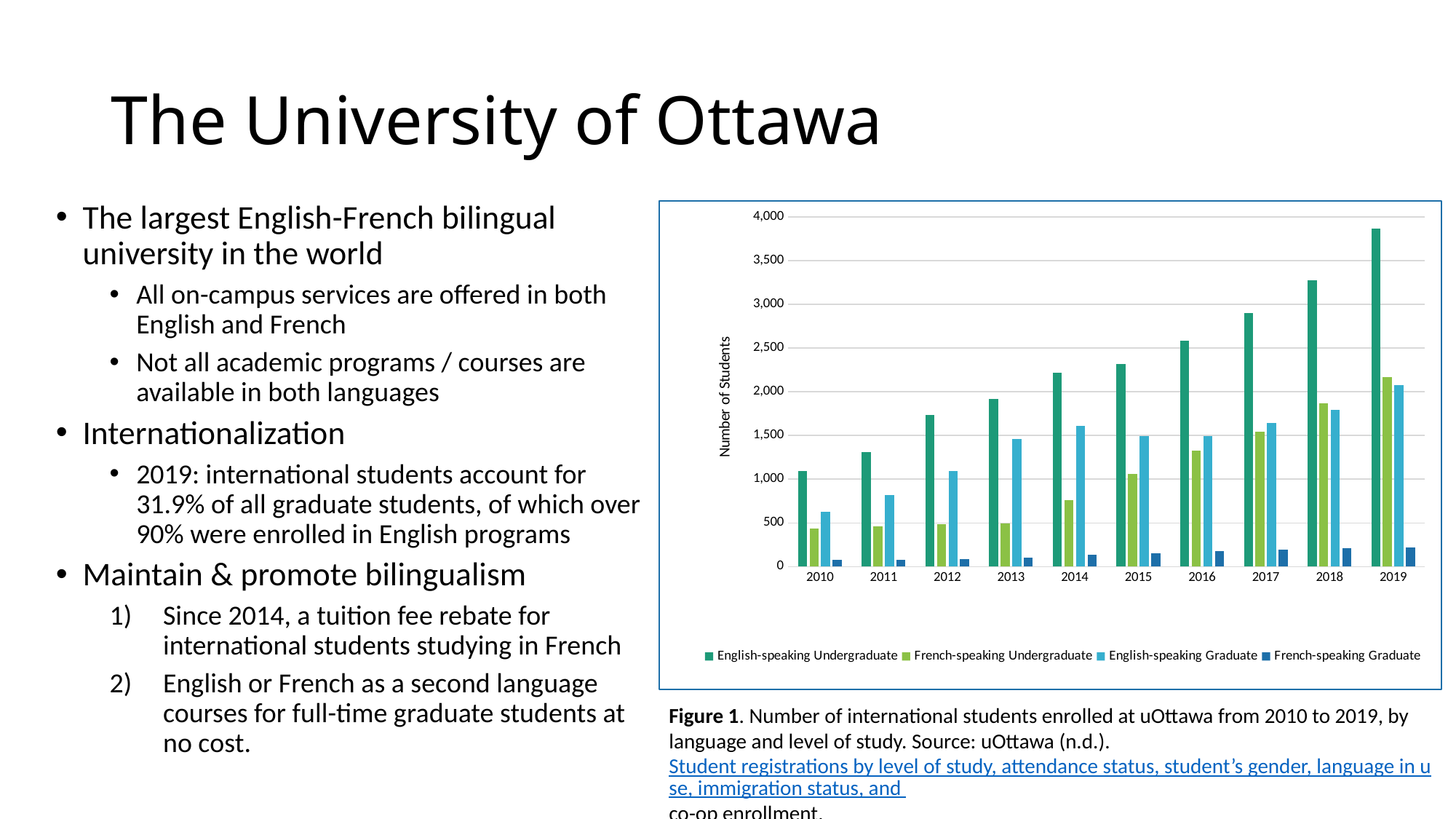
Is the value for English-speaking Undergraduate in 2019 greater or less than 3,500? greater In 2014, which is larger: French-speaking Undergraduate or English-speaking Graduate? English-speaking Graduate Do the English-speaking Undergraduate values rise or fall from 2010 to 2019? rise How many years are shown along the x axis of the chart? 10 What is the label on the chart's y axis? Number of Students How many series does the chart's legend list? 4 In which year is the English-speaking Undergraduate bar the tallest? 2019 Is the value for French-speaking Undergraduate in 2010 greater or less than 500? less Is the value for English-speaking Graduate in 2019 greater or less than 2,000? greater What kind of chart is shown on the slide? Bar chart Which series has the lowest values in every year shown? French-speaking Graduate